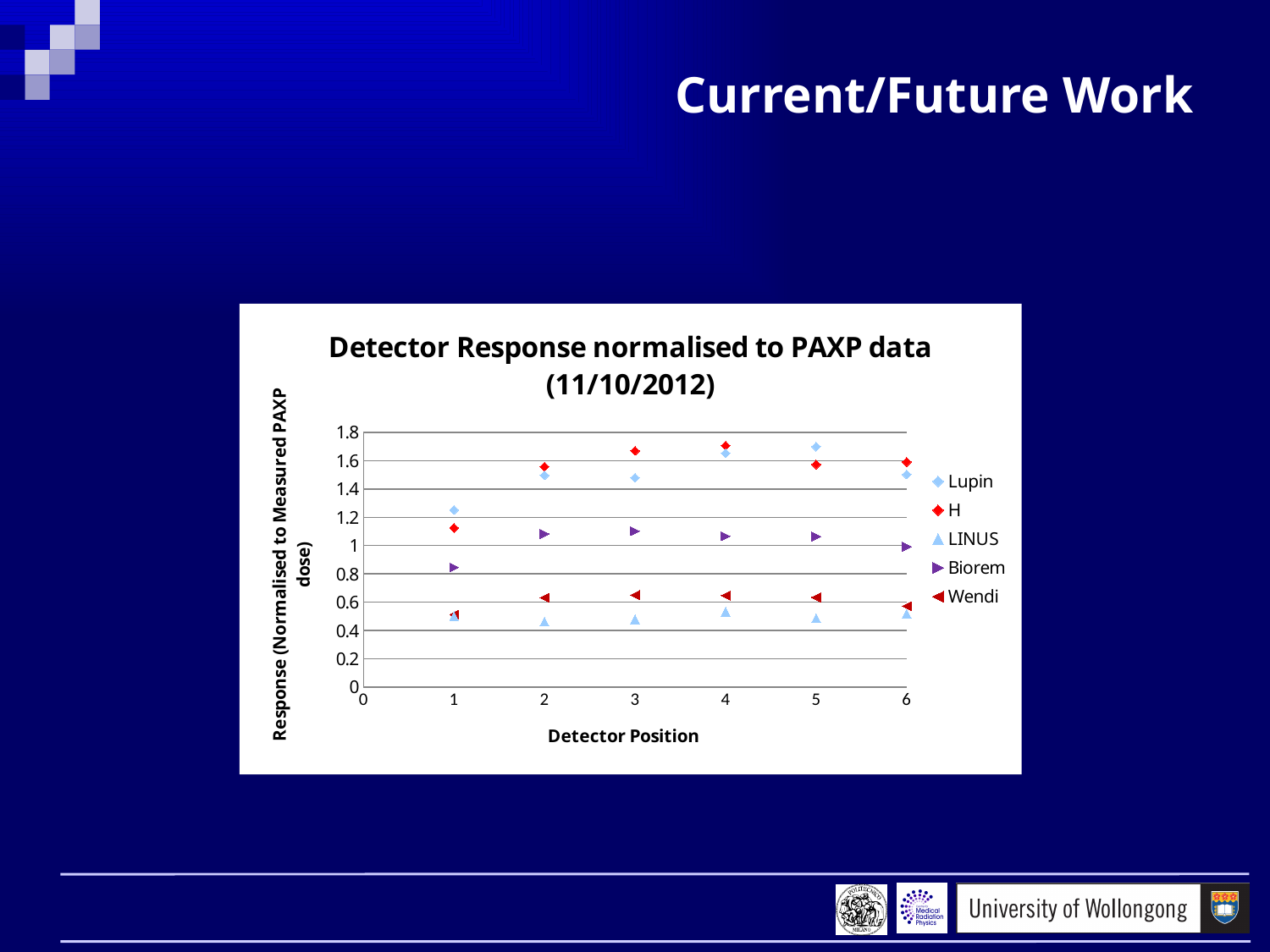
What is the title of the x axis? Detector Position How many detector positions are plotted for each series? 6 Is the Biorem value at detector position 1 greater or less than 1? less Is the H value at detector position 4 greater or less than 1.6? greater Is the LINUS value at detector position 2 greater or less than 0.6? less Which series has the highest value at detector position 4? H At detector position 3, which is higher: Wendi or LINUS? Wendi Which series has the lowest value at detector position 2? LINUS How many series does the legend list? 5 What kind of chart is shown on the slide? scatter chart At detector position 1, which is higher: Lupin or H? Lupin